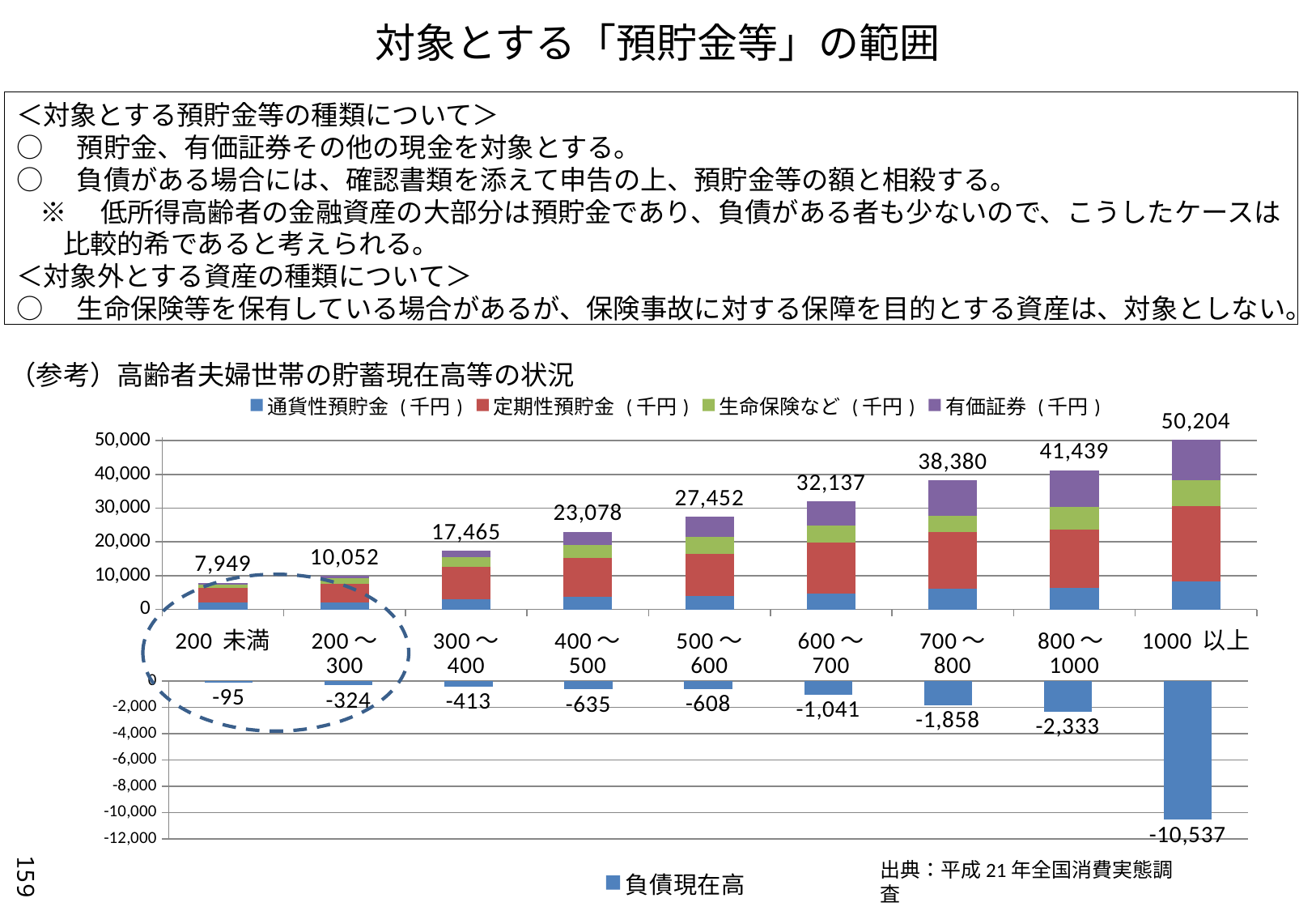
In the top stacked bar chart, what is the difference between the totals for 300〜400 and 200〜300? 7,413 In the bottom chart (負債現在高), what is the value for the 600〜700 category? -1,041 How many categories are shown in the bottom chart (負債現在高)? 9 How many series does the legend of the top stacked bar chart list? 4 In the bottom chart (負債現在高), which category has the lowest (most negative) value? 1000 以上 In the top stacked bar chart, which category has the lowest total? 200 未満 In the top stacked bar chart, which colour represents 定期性預貯金（千円）? Red In the top stacked bar chart, which category has the highest total? 1000 以上 In the bottom chart (負債現在高), which category has the larger debt, 700〜800 or 800〜1000? 800〜1000 In the top stacked bar chart, do the totals rise or fall from 200 未満 to 1000 以上? Rise What kind of chart is the top chart on the slide? Stacked bar chart In the top stacked bar chart, what is the total labelled for the 1000 以上 category? 50,204